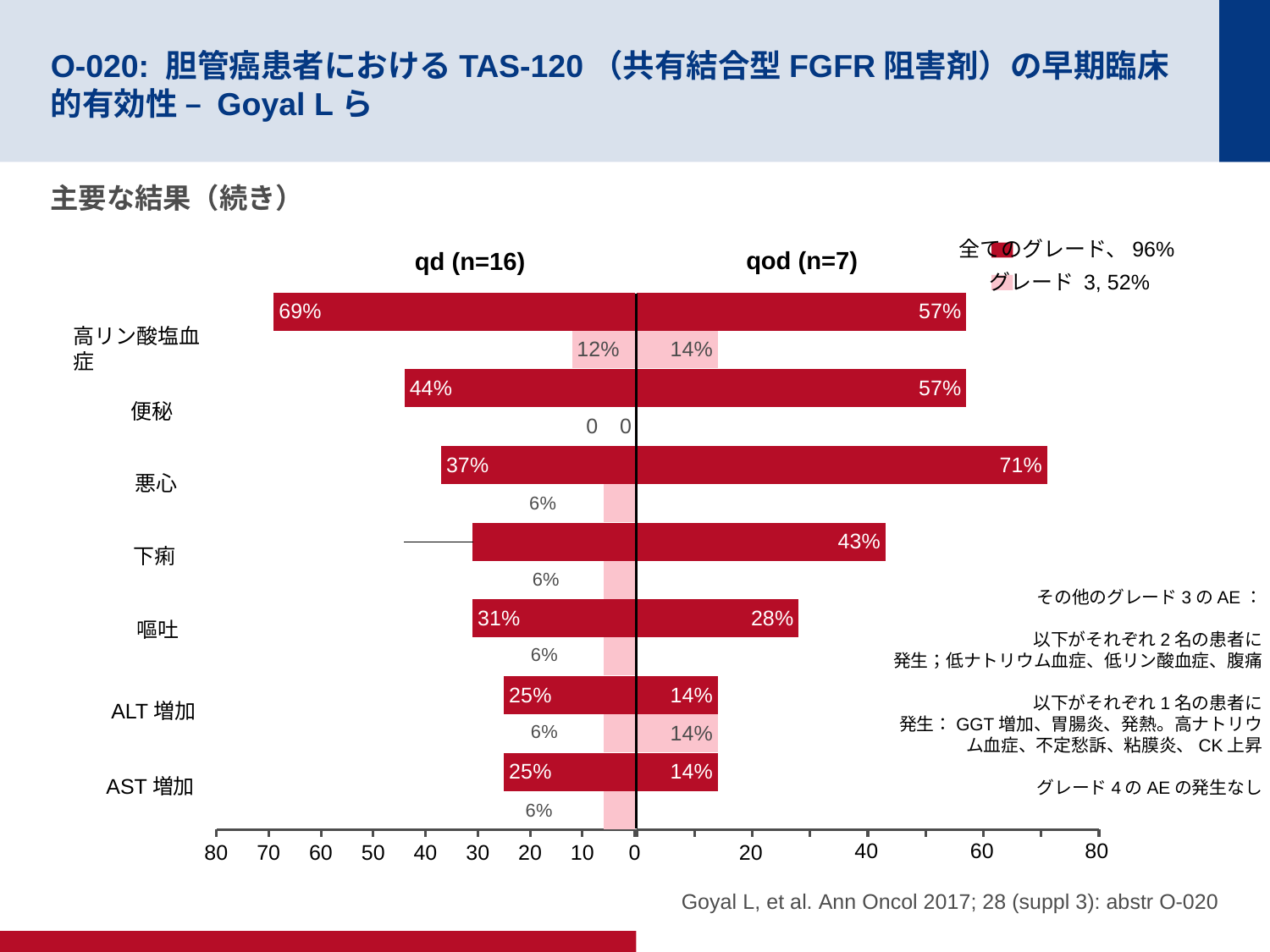
What percentage of patients in the qd (n=16) group had any-grade 高リン酸塩血症? 69% Which group has the higher all-grade rate of 便秘, qd (n=16) or qod (n=7)? qod (n=7) What is the all-grade rate of 悪心 in the qod (n=7) group? 71% Which adverse event has the highest all-grade rate in the qod (n=7) group? 悪心 What is the difference between the all-grade rates of 高リン酸塩血症 in the qd (n=16) and qod (n=7) groups? 12% Which adverse event has the highest all-grade rate in the qd (n=16) group? 高リン酸塩血症 What overall percentage is given next to the 全てのグレード legend entry? 96% What is the grade 3 rate of 高リン酸塩血症 in the qod (n=7) group? 14% How many series does the legend list? 2 How many adverse event categories are shown on the chart? 7 Is the all-grade rate of 下痢 in the qd (n=16) group greater or less than 20? greater What kind of chart is shown on the slide? Bar chart